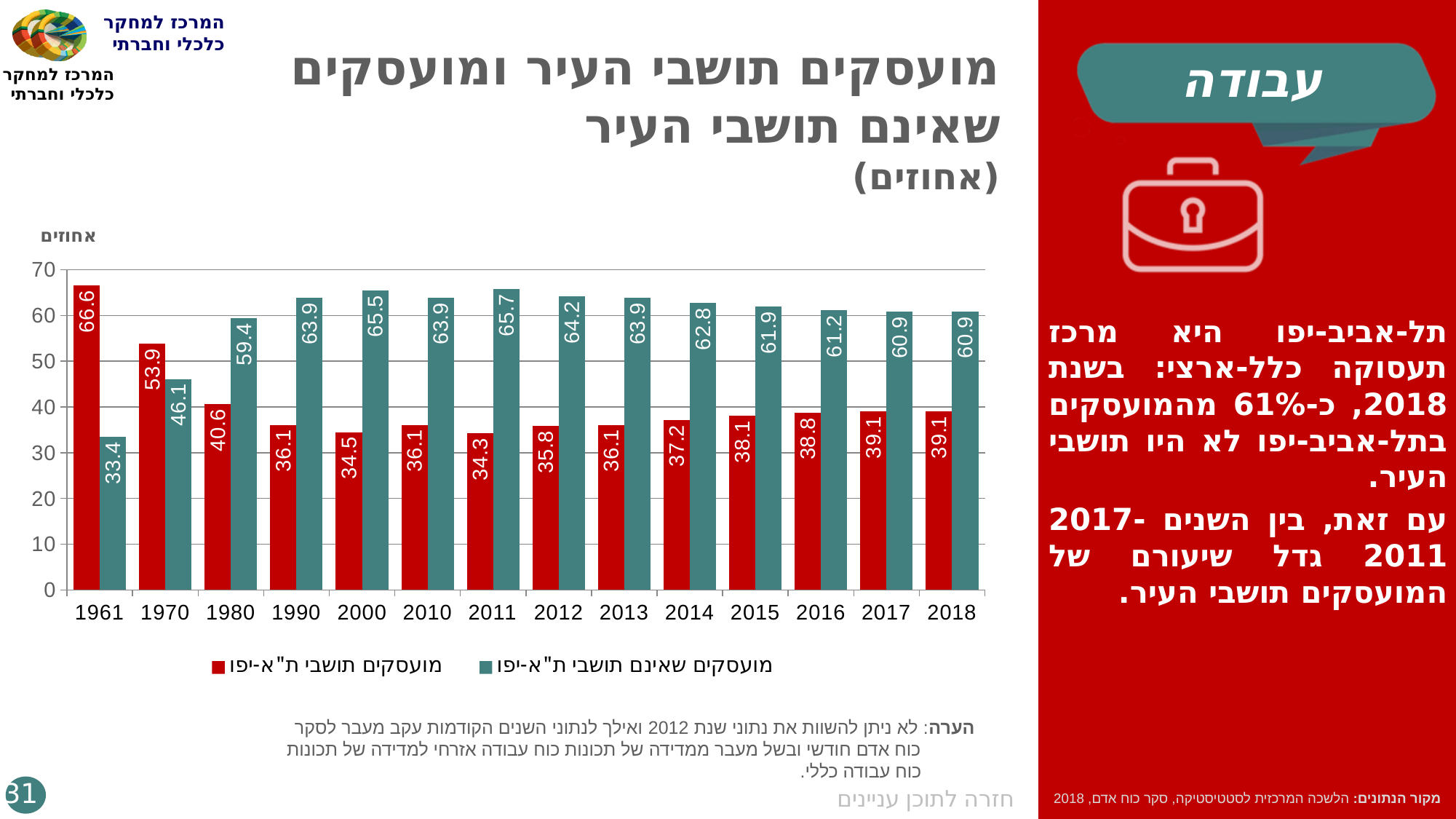
What is the value for employed residents of Tel Aviv-Yafo (מועסקים תושבי ת"א-יפו) in 1961? 66.6 Which series has the larger value in 1970: employed residents (מועסקים תושבי ת"א-יפו) or employed non-residents (מועסקים שאינם תושבי ת"א-יפו)? מועסקים תושבי ת"א-יפו Is the value for employed non-residents of Tel Aviv-Yafo (מועסקים שאינם תושבי ת"א-יפו) in 1980 greater or less than 50? greater What is the value for employed residents of Tel Aviv-Yafo (מועסקים תושבי ת"א-יפו) in 2011? 34.3 In which year is the value for employed non-residents of Tel Aviv-Yafo (מועסקים שאינם תושבי ת"א-יפו) highest? 2011 What is the difference between the two series' values in 1961? 33.2 Between 2011 and 2017, does the value for employed residents of Tel Aviv-Yafo (מועסקים תושבי ת"א-יפו) rise or fall? rise In which year is the value for employed residents of Tel Aviv-Yafo (מועסקים תושבי ת"א-יפו) lowest? 2011 What kind of chart is shown on the slide? bar chart How many years are shown on the x axis of the chart? 14 What is the value for employed non-residents of Tel Aviv-Yafo (מועסקים שאינם תושבי ת"א-יפו) in 2018? 60.9 How many series does the chart's legend list? 2